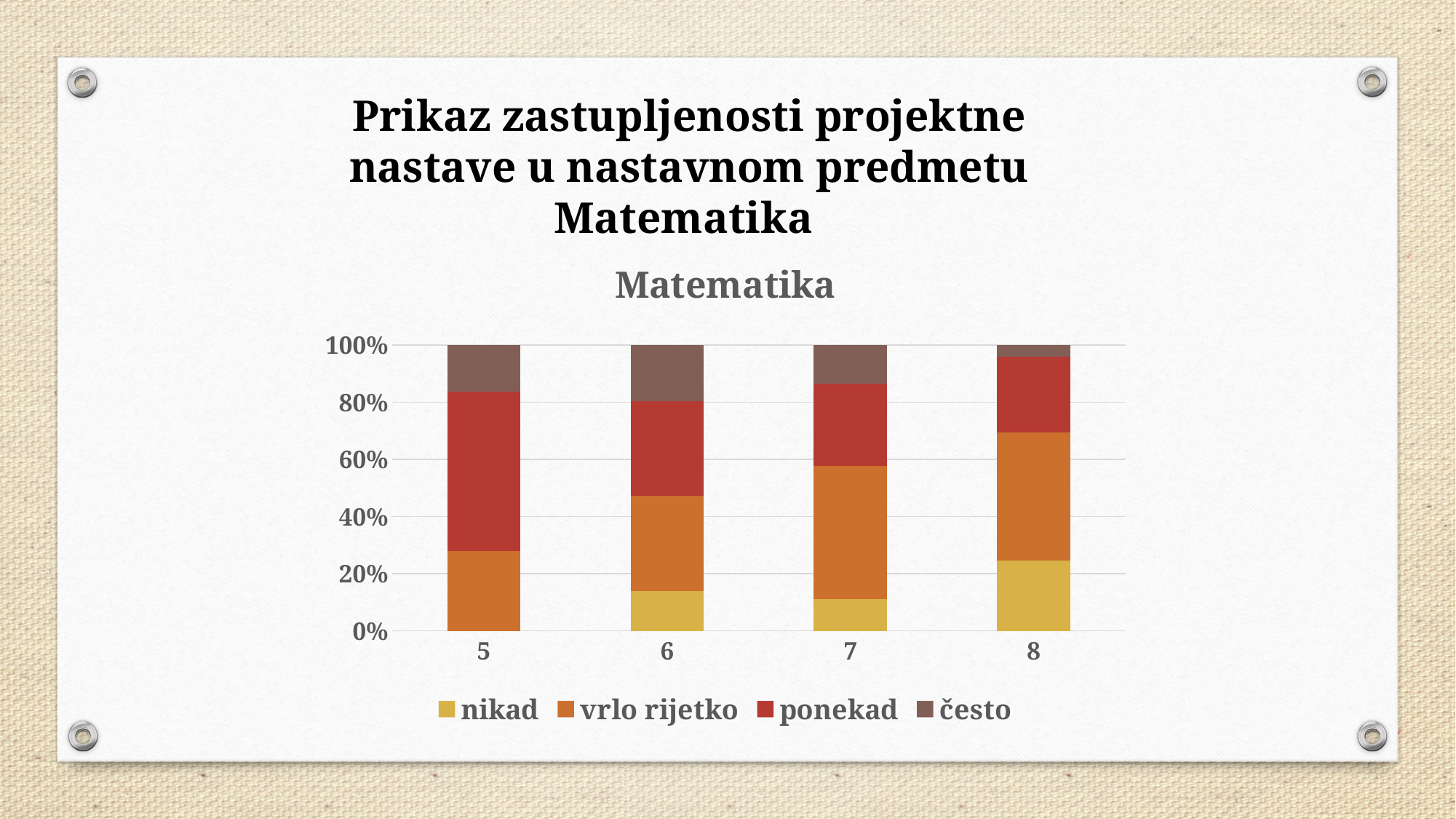
What is the title of the chart? Matematika Does the 'ponekad' share rise or fall from category 5 to category 8? fall Is the 'nikad' share for category 8 greater or less than 20%? greater Which is larger, the 'ponekad' share for category 5 or for category 8? category 5 How many categories are shown on the x axis of the chart? 4 What kind of chart is shown on the slide? stacked bar chart How many series does the legend list? 4 Which category has the largest 'nikad' share? 8 Is the 'ponekad' share for category 5 greater or less than 40%? greater Which series is shown in yellow in the legend? nikad Which category has the smallest 'često' share? 8 Which category has the largest 'ponekad' share? 5